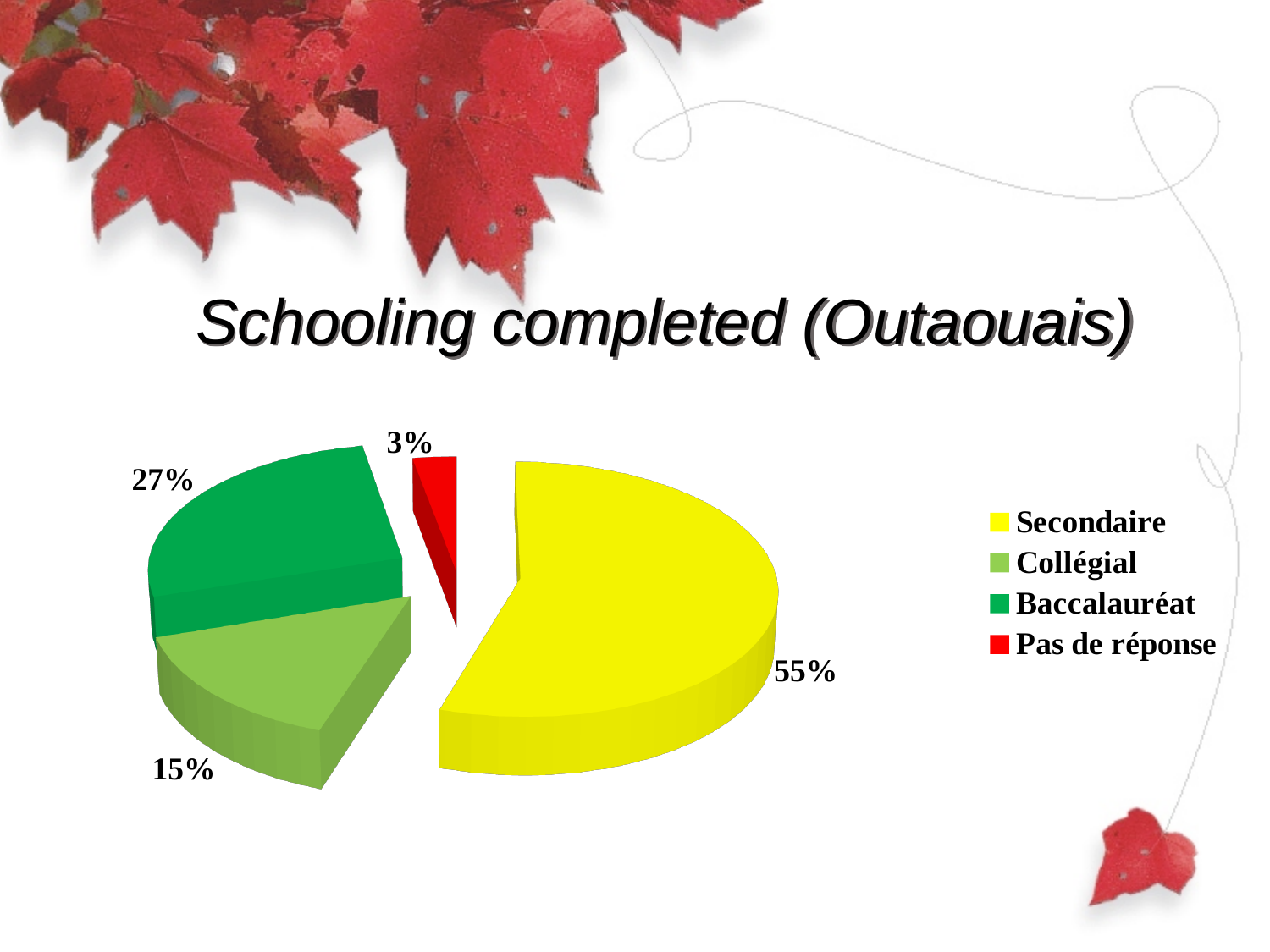
Which category has the smallest slice of the pie? Pas de réponse What is the title of the chart? Schooling completed (Outaouais) What is the difference between the Secondaire and Baccalauréat shares? 28% What share of the pie does Secondaire represent? 55% What is the value shown for Baccalauréat? 27% How many categories does the legend list? 4 What colour is the Pas de réponse slice? Red What is the value shown for Pas de réponse? 3% Which is larger, the Collégial share or the Baccalauréat share? Baccalauréat Which category has the largest slice of the pie? Secondaire What kind of chart is shown on the slide? Pie chart What is the value shown for Collégial? 15%